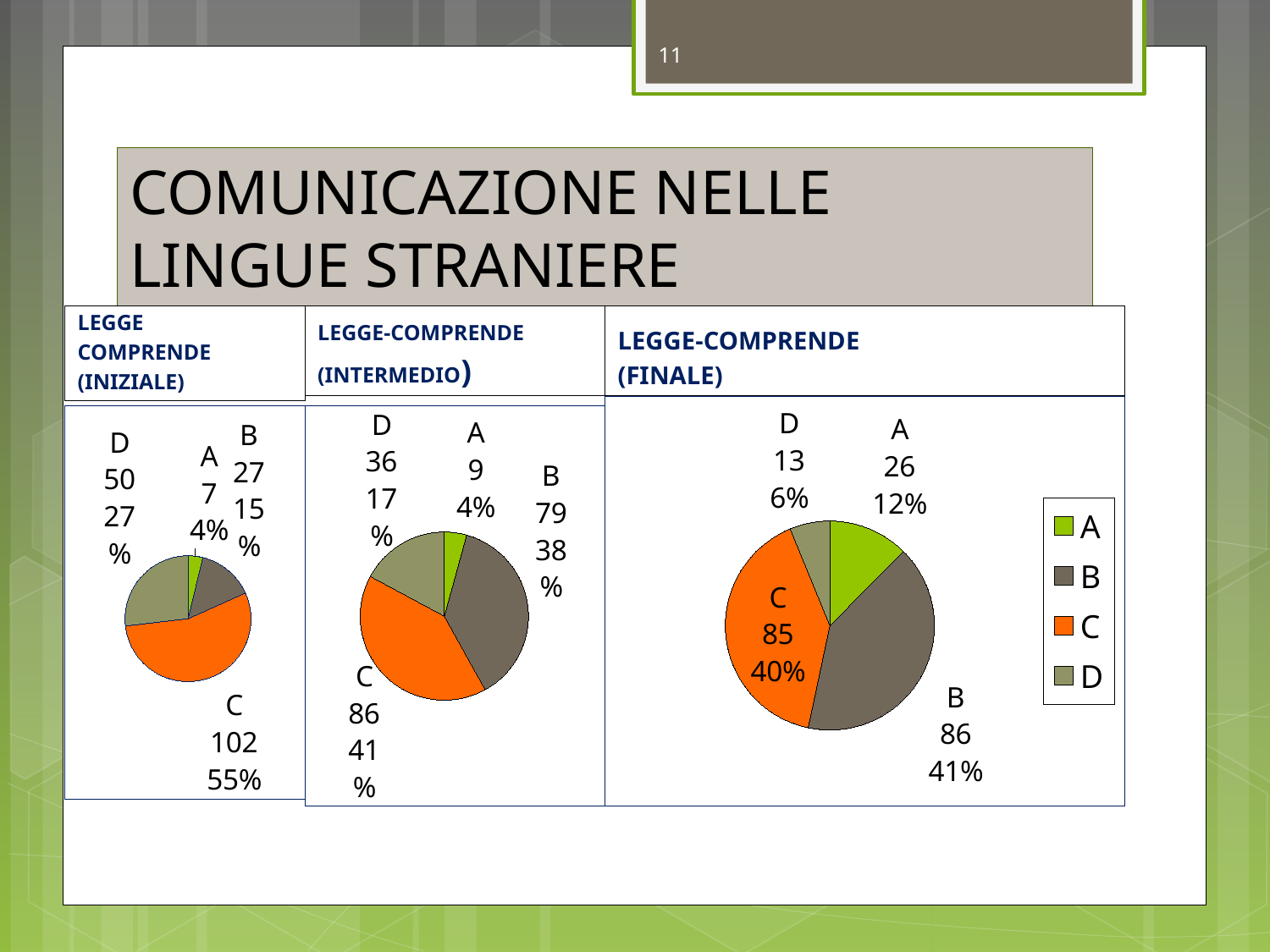
In the LEGGE-COMPRENDE (INTERMEDIO) pie chart, which category has the largest slice? C In the LEGGE COMPRENDE (INIZIALE) pie chart, what is the value for category C? 102 What type of chart is used in the LEGGE-COMPRENDE (FINALE) panel? Pie chart In the LEGGE COMPRENDE (INIZIALE) pie chart, which is larger, the value for B or the value for D? D In the LEGGE-COMPRENDE (FINALE) pie chart, what is the value for category B? 86 In the LEGGE COMPRENDE (INIZIALE) pie chart, which category has the smallest slice? A In the LEGGE COMPRENDE (INIZIALE) pie chart, what percentage share does category D have? 27% In the LEGGE-COMPRENDE (FINALE) pie chart, what percentage share does category A have? 12% In the LEGGE-COMPRENDE (FINALE) pie chart, which category has the smallest slice? D How many categories does the legend on the slide list? 4 In the LEGGE-COMPRENDE (INTERMEDIO) pie chart, what is the difference between the values for C and D? 50 In the LEGGE-COMPRENDE (INTERMEDIO) pie chart, what is the value for category B? 79